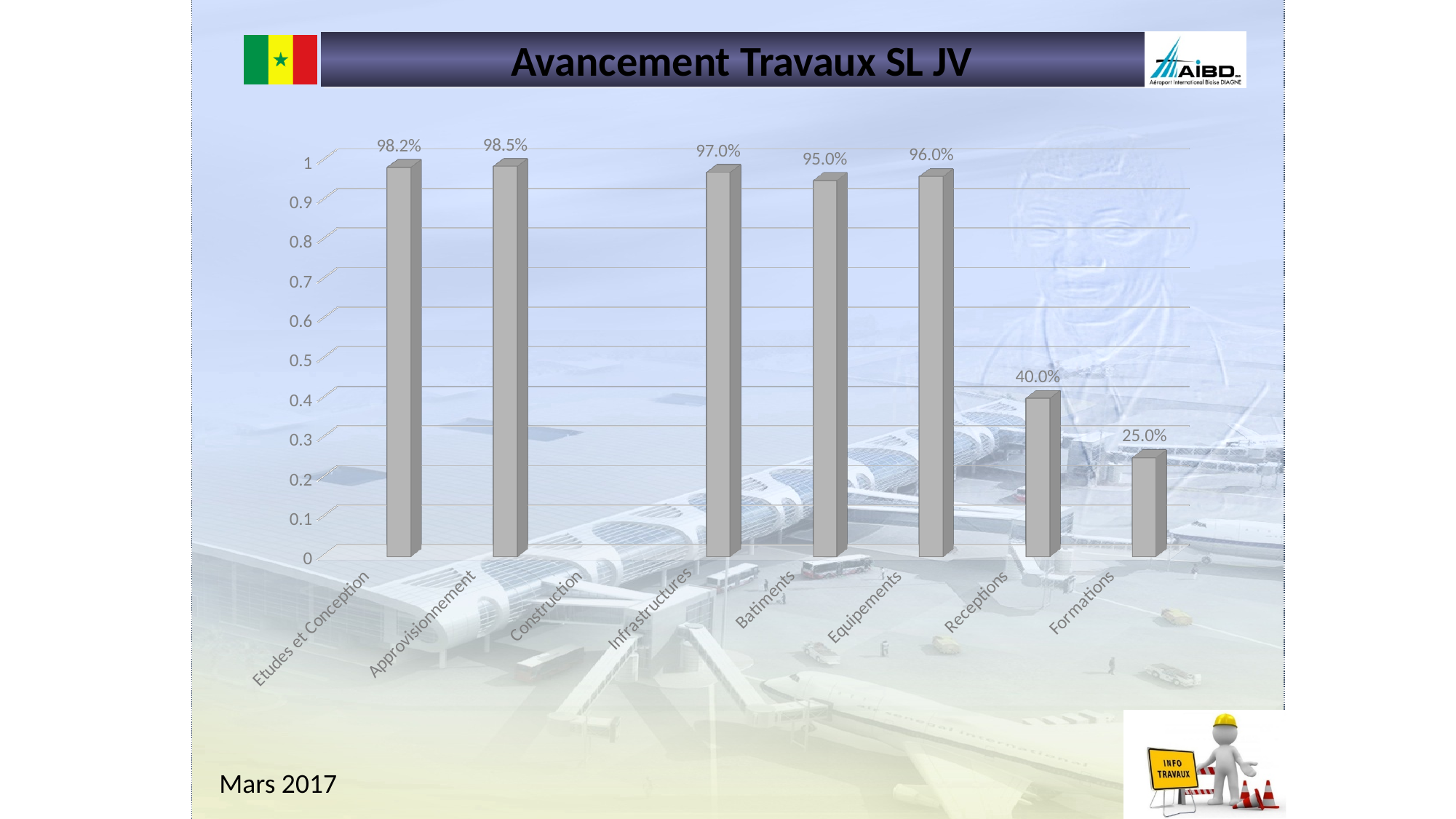
What is the value for Etudes et Conception? 98.2% Which category has the highest value? Approvisionnement What is the value for Approvisionnement? 98.5% Is the value for Receptions greater or less than 0.5? less What kind of chart is shown on the slide? bar chart Which is larger, the value for Batiments or the value for Equipements? Equipements What is the value for Formations? 25.0% Which category has the lowest value? Formations What is the value for Receptions? 40.0% What is the difference between the values for Infrastructures and Batiments? 2.0% What is the difference between the values for Receptions and Formations? 15.0% What is the title of the chart? Avancement Travaux SL JV